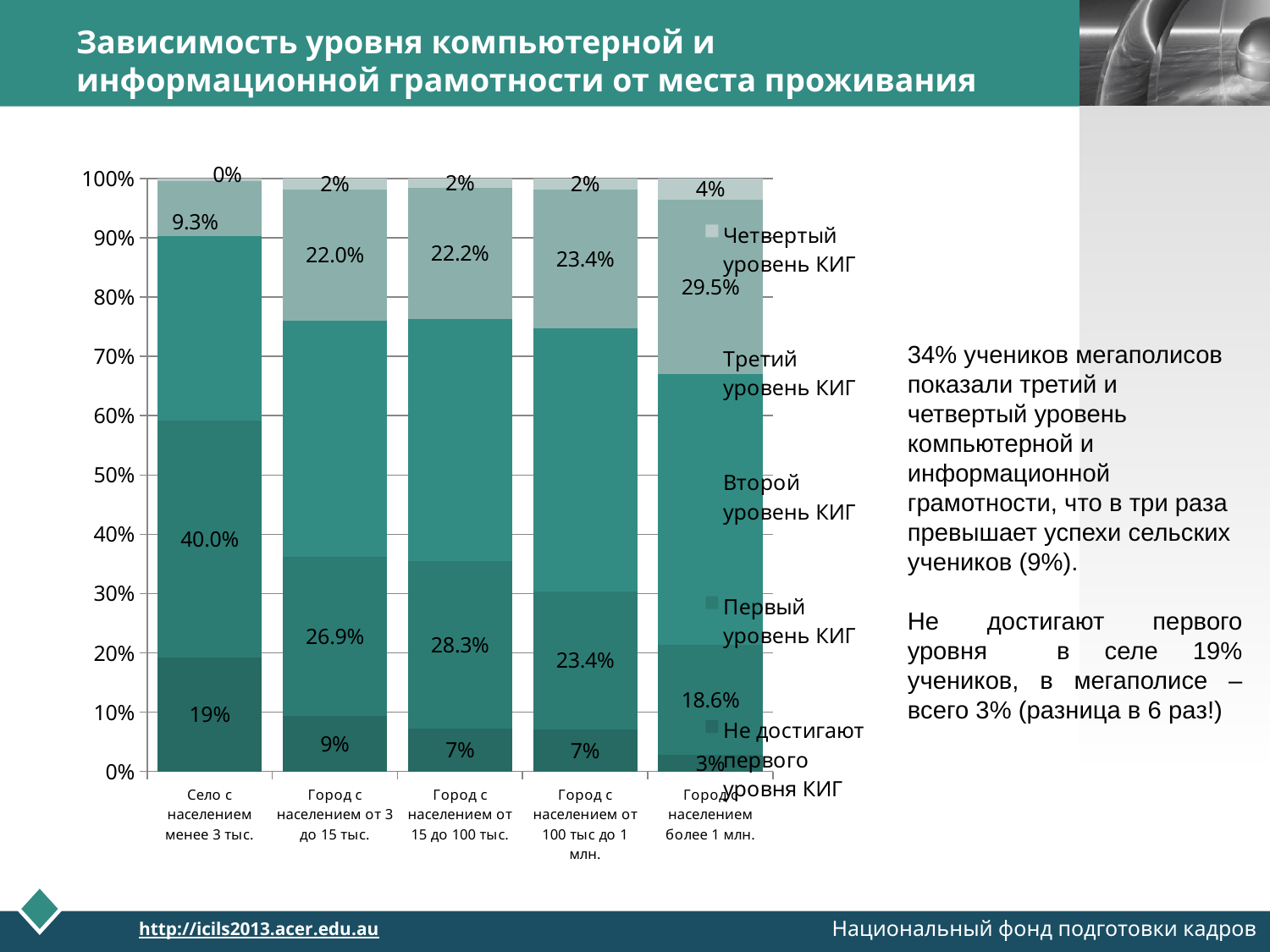
What is the value of 'Четвертый уровень КИГ' for 'Село с населением менее 3 тыс.'? 0% How many categories (types of settlement) are shown on the x axis? 5 What is the difference between the 'Не достигают первого уровня КИГ' values for 'Село с населением менее 3 тыс.' and 'Город с населением более 1 млн.'? 16 percentage points Which is larger: the 'Первый уровень КИГ' value for 'Село с населением менее 3 тыс.' or for 'Город с населением более 1 млн.'? Село с населением менее 3 тыс. What is the value of 'Первый уровень КИГ' for 'Город с населением от 15 до 100 тыс.'? 28.3% Which category has the lowest value for 'Не достигают первого уровня КИГ'? Город с населением более 1 млн. What kind of chart is shown on the slide? Stacked bar chart What is the value of 'Третий уровень КИГ' for 'Город с населением более 1 млн.'? 29.5% What is the value of 'Не достигают первого уровня КИГ' for 'Село с населением менее 3 тыс.'? 19% How many series does the legend list? 5 Does the 'Третий уровень КИГ' value rise or fall from the village category to the city of more than 1 million? Rises Which category has the highest value for 'Четвертый уровень КИГ'? Город с населением более 1 млн.